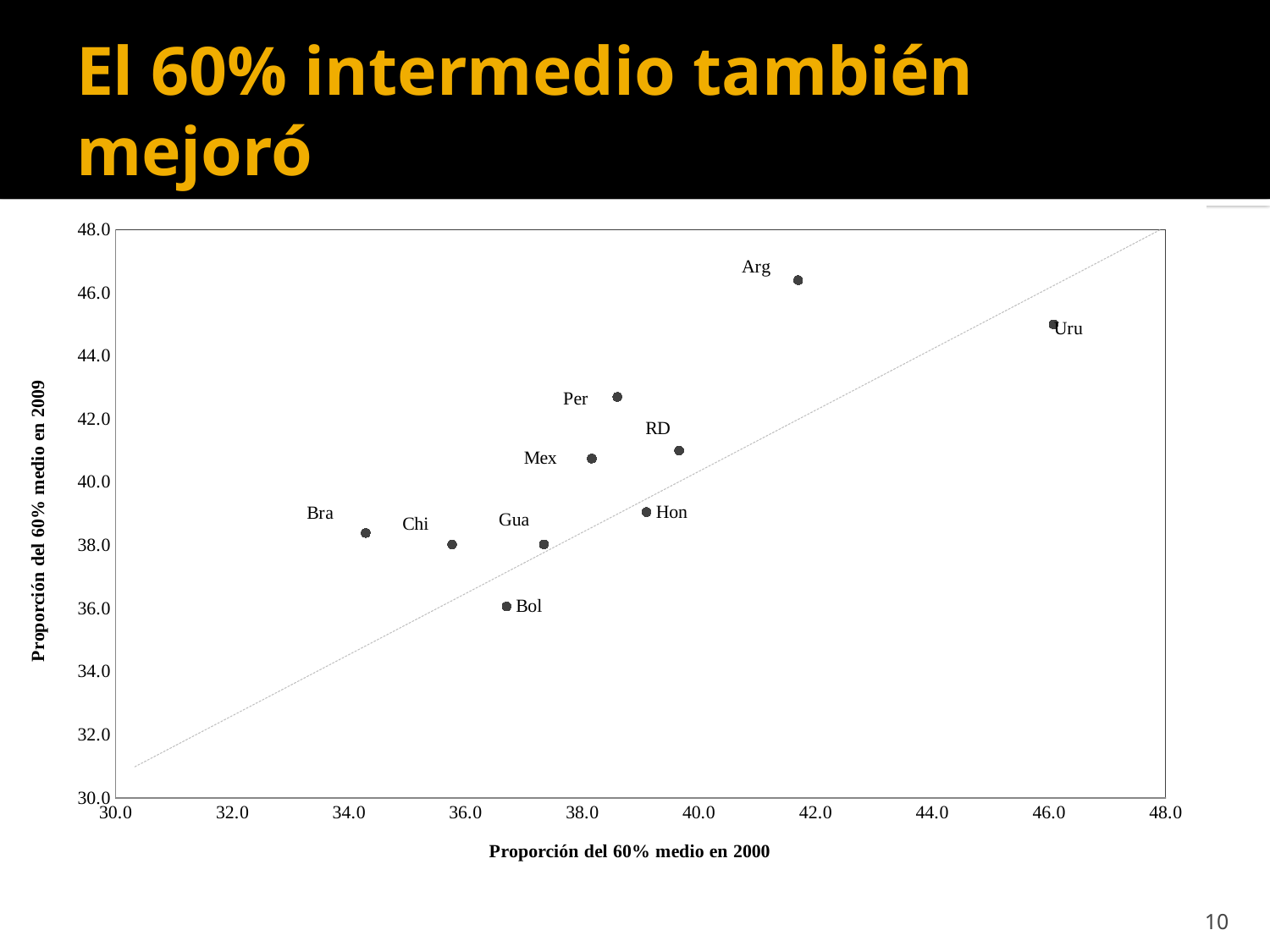
Which has the higher 2009 value, Per or RD? Per How many countries are plotted as points on the chart? 10 What kind of chart is shown on the slide? scatter chart Is the 2000 value for Bra greater or less than 36.0? less Is the 2009 value for Arg greater or less than 44.0? greater Which country has the highest value on the horizontal axis (Proporción del 60% medio en 2000)? Uru Which country has the lowest value on the vertical axis (Proporción del 60% medio en 2009)? Bol What is the title of the horizontal axis? Proporción del 60% medio en 2000 Which country has the lowest value on the horizontal axis (Proporción del 60% medio en 2000)? Bra Is the 2009 value for Bol greater or less than 38.0? less Which country has the highest value on the vertical axis (Proporción del 60% medio en 2009)? Arg